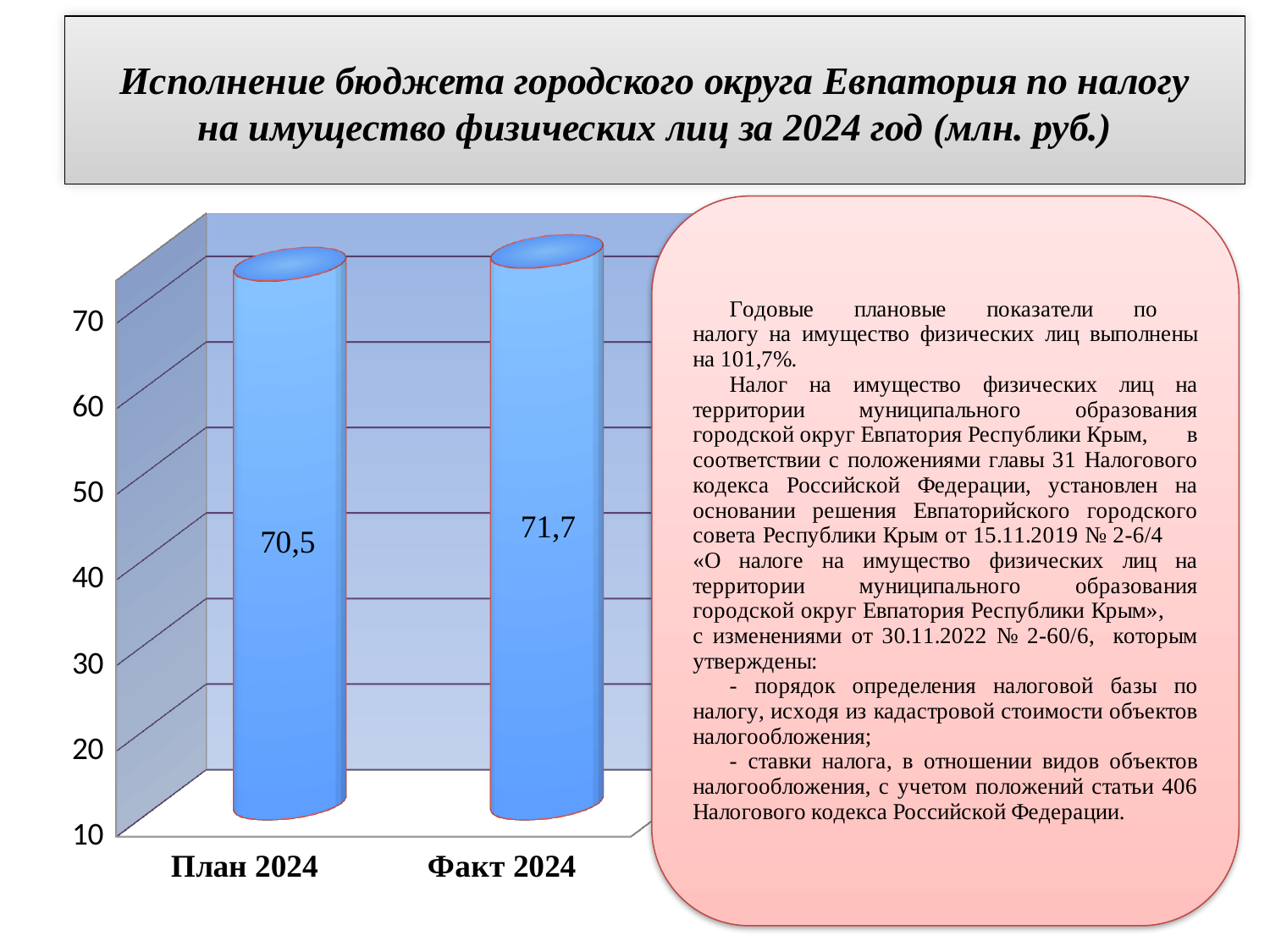
What is the value for План 2024? 70,5 What kind of chart is shown on the slide? bar chart Which category has the lowest value? План 2024 Do the values rise or fall from План 2024 to Факт 2024? rise What unit is given in the slide title for the chart values? млн. руб. What is the difference between the values for Факт 2024 and План 2024? 1,2 Is the value for План 2024 greater or less than 60? greater Which category has the highest value? Факт 2024 Which is larger, the value for План 2024 or the value for Факт 2024? Факт 2024 What is the value for Факт 2024? 71,7 What is the lowest value shown on the vertical axis of the chart? 10 How many categories are shown on the chart? 2